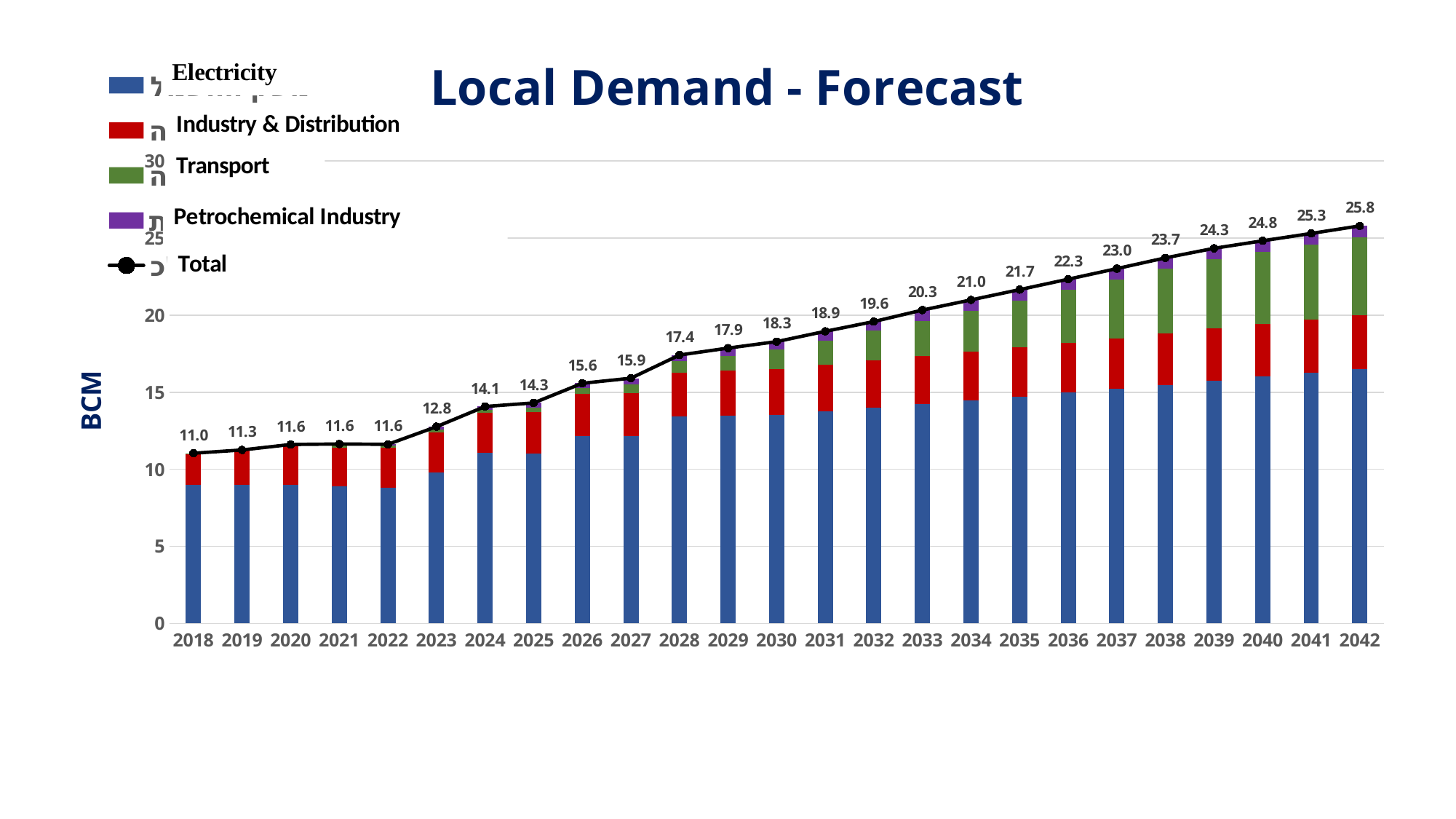
Do the Total values rise or fall from 2018 to 2042? rise How many years are shown on the x axis? 25 Is the Electricity value for 2018 greater or less than 10? less What is the Total value for 2042? 25.8 How many series does the legend list? 5 Which year has the lowest Total value? 2018 What is the difference between the Total values for 2042 and 2018? 14.8 Which year has the highest Total value? 2042 Is the Electricity value for 2042 greater or less than 15? greater What is the label on the y axis? BCM What is the Total value for 2030? 18.3 Which year has the larger Total value, 2034 or 2035? 2035